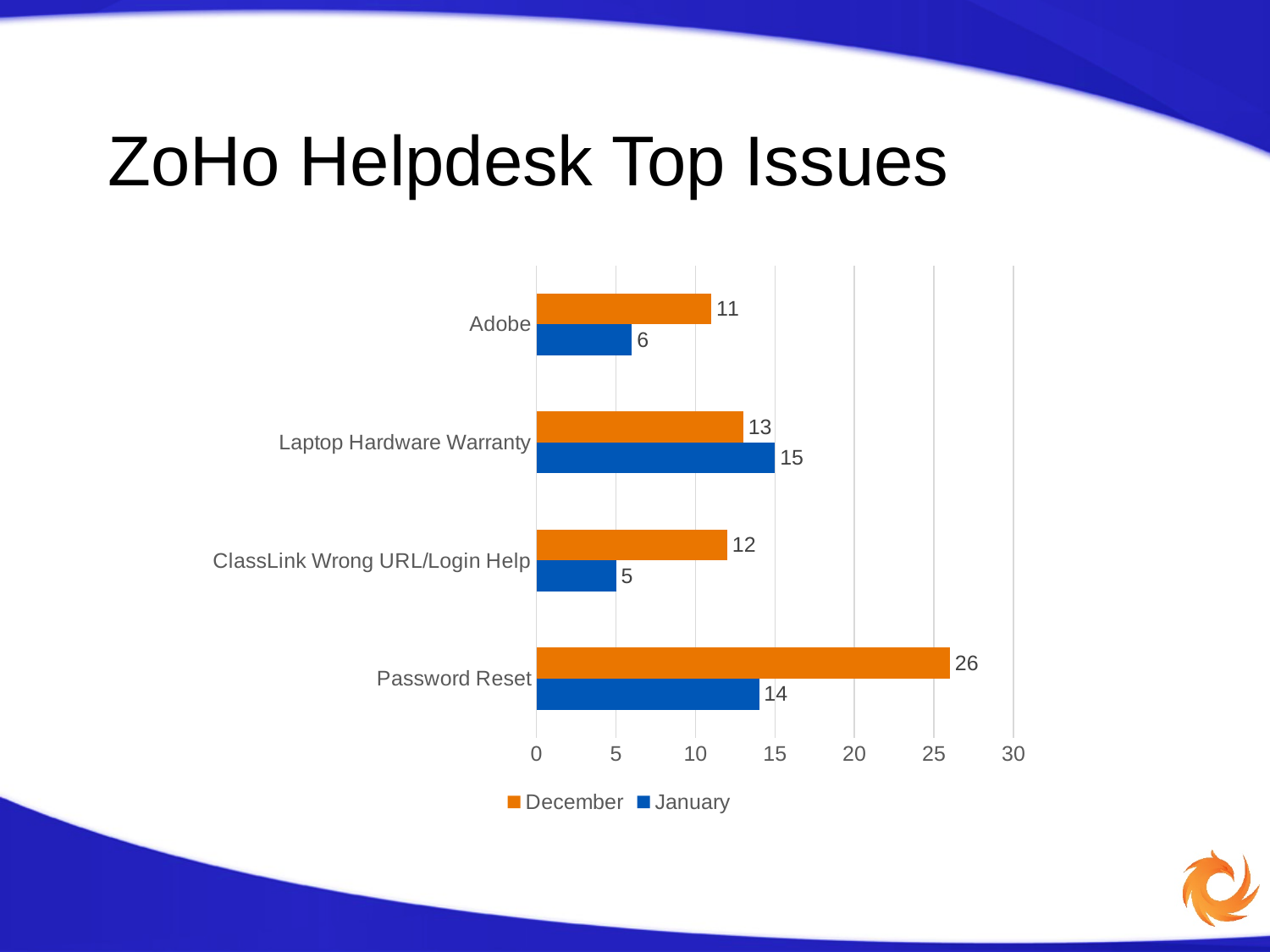
What is the December value for ClassLink Wrong URL/Login Help? 12 Which category has the lowest January value? ClassLink Wrong URL/Login Help How many categories are shown on the chart? 4 What is the difference between the December and January values for Password Reset? 12 Which colour represents the January series? Blue How many series does the legend list? 2 Which category has the highest December value? Password Reset What is the January value for Laptop Hardware Warranty? 15 For Laptop Hardware Warranty, which is larger: the December value or the January value? January What kind of chart is shown on the slide? Bar chart What is the January value for Adobe? 6 What is the December value for Password Reset? 26